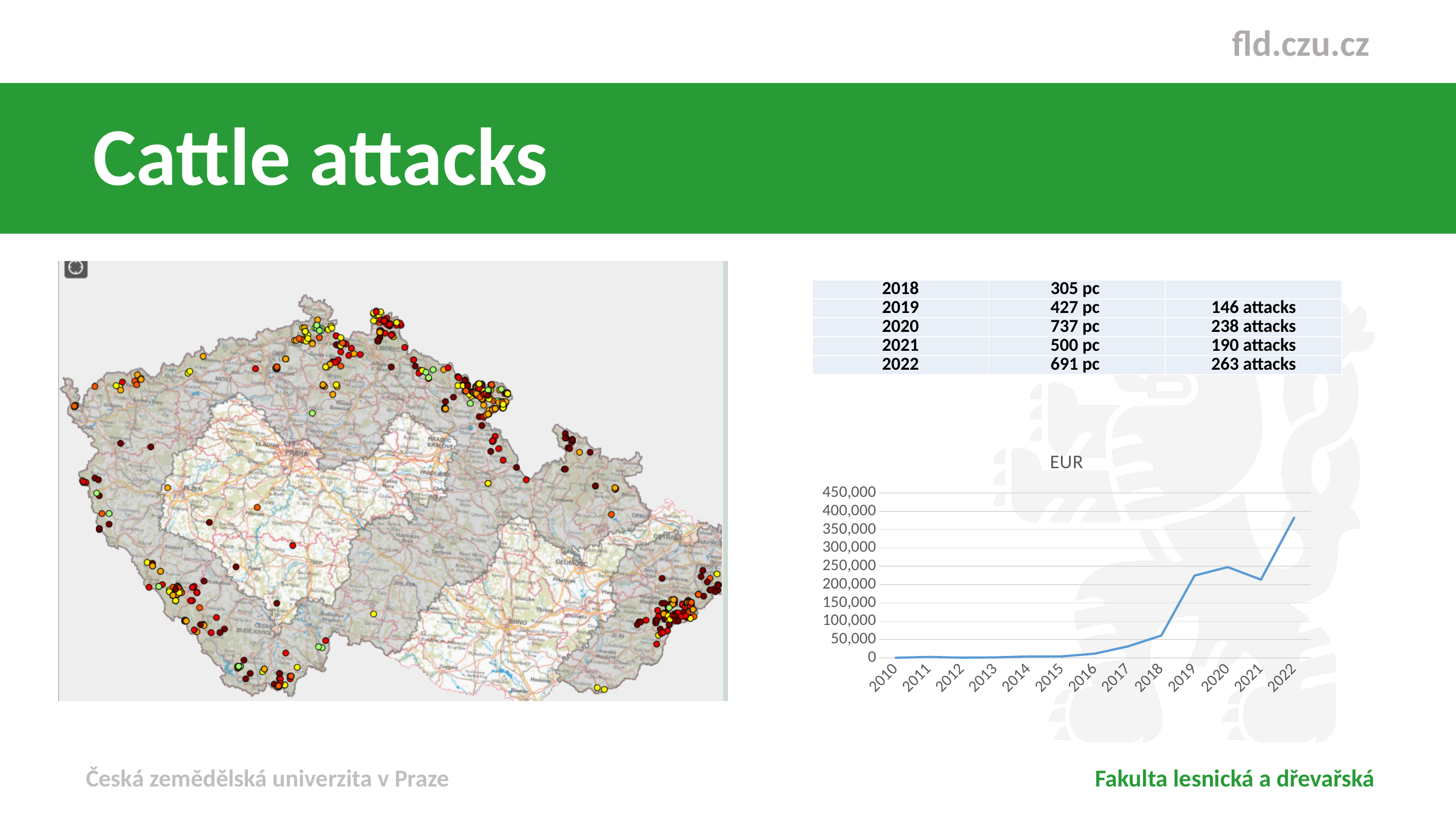
In the EUR chart, which year has the highest value? 2022 How many years are plotted along the x axis of the EUR chart? 13 In the EUR chart, which year has the larger value, 2018 or 2019? 2019 In the EUR chart, is the value for 2022 greater or less than 350,000? greater What is the title of the chart on the right of the slide? EUR In the EUR chart, is the value for 2021 greater or less than 250,000? less In the EUR chart, is the value for 2017 greater or less than 50,000? less In the EUR chart, which year has the larger value, 2020 or 2022? 2022 In the EUR chart, do the values generally rise or fall from 2010 to 2022? rise What kind of chart is the EUR chart on the right of the slide? line chart